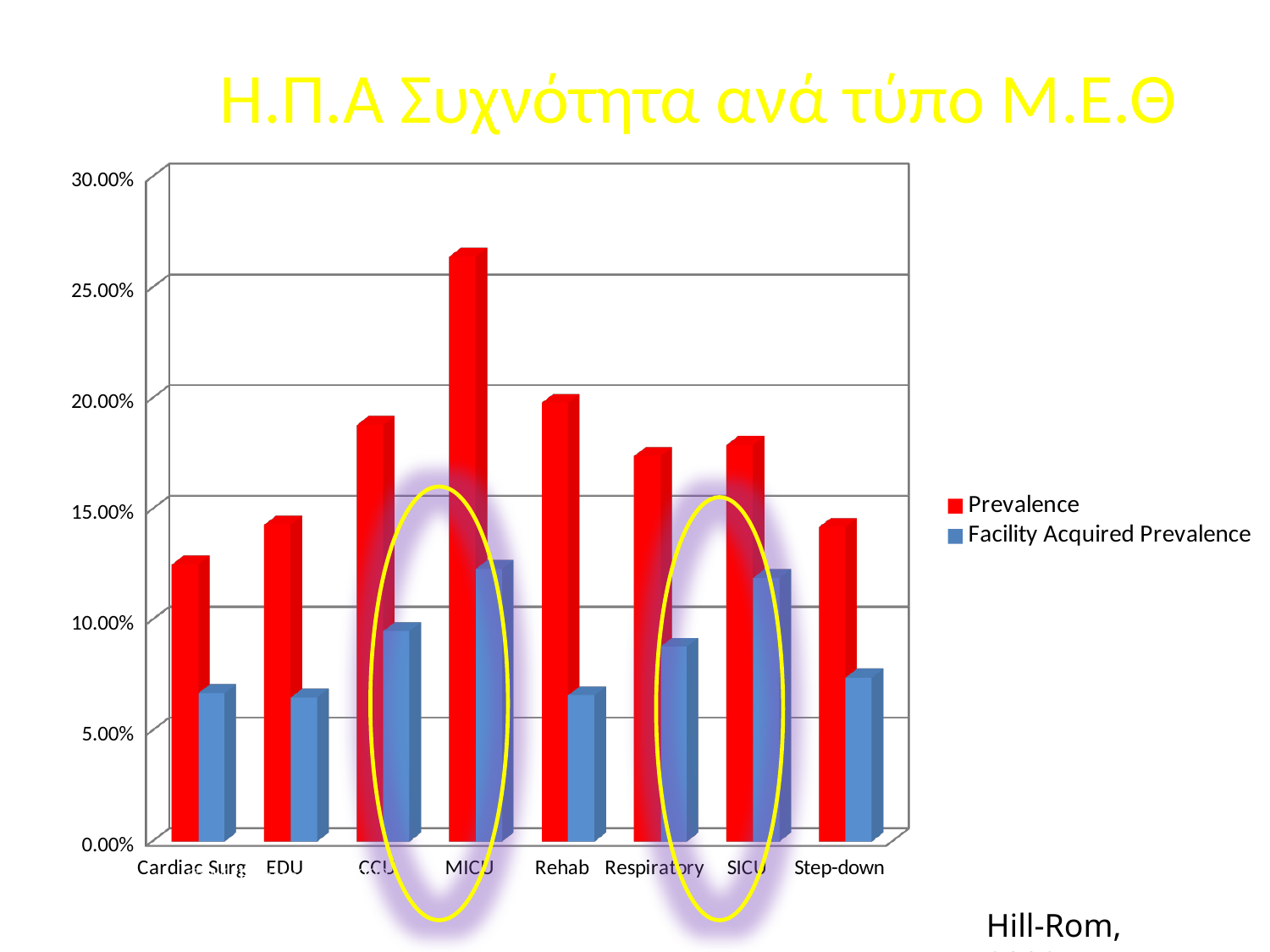
Which category has the lowest Prevalence? Cardiac Surg Which has the larger Prevalence, MICU or Rehab? MICU Is the Prevalence value for MICU greater or less than 25.00%? greater How many unit types (categories) are shown on the x axis? 8 Is the Facility Acquired Prevalence value for Rehab greater or less than 10.00%? less Which has the larger Facility Acquired Prevalence, CCU or EDU? CCU How many series does the legend list? 2 Which category has the highest Prevalence? MICU Which colour represents the Prevalence series in the legend? red Is the Prevalence value for CCU greater or less than 20.00%? less What kind of chart is shown on the slide? bar chart